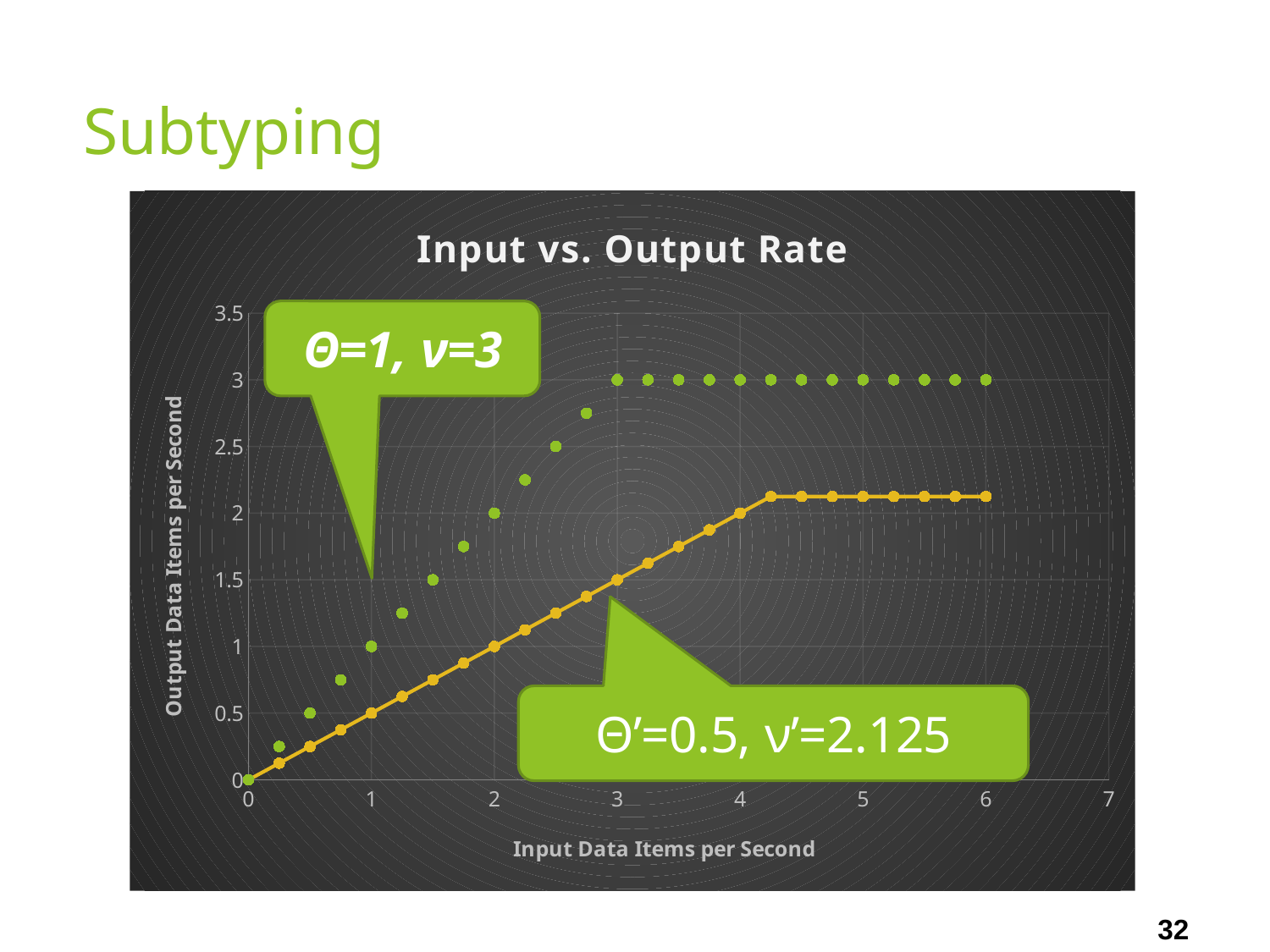
What is the difference between the green series and the orange series output rates at an input rate of 4? 1 What is the title of the chart? Input vs. Output Rate Is the plateau value of the orange (Θ'=0.5, ν'=2.125) series greater or less than 2? greater At an input rate of 2, which series has the higher output rate, the green (Θ=1, ν=3) or the orange (Θ'=0.5, ν'=2.125)? green (Θ=1, ν=3) Does the orange (Θ'=0.5, ν'=2.125) series rise or fall as the input rate increases from 0 to 4? rise Is the output rate of the orange (Θ'=0.5, ν'=2.125) series at an input rate of 1 greater or less than 1? less At what output rate does the green (Θ=1, ν=3) series level off? 3 What output rate does the green (Θ=1, ν=3) series reach at an input rate of 1? 1 What is the label of the x axis? Input Data Items per Second What is the output rate of the orange (Θ'=0.5, ν'=2.125) series at an input rate of 2? 1 How many data series are plotted on the chart? 2 What is the output rate of the orange (Θ'=0.5, ν'=2.125) series at an input rate of 4? 2